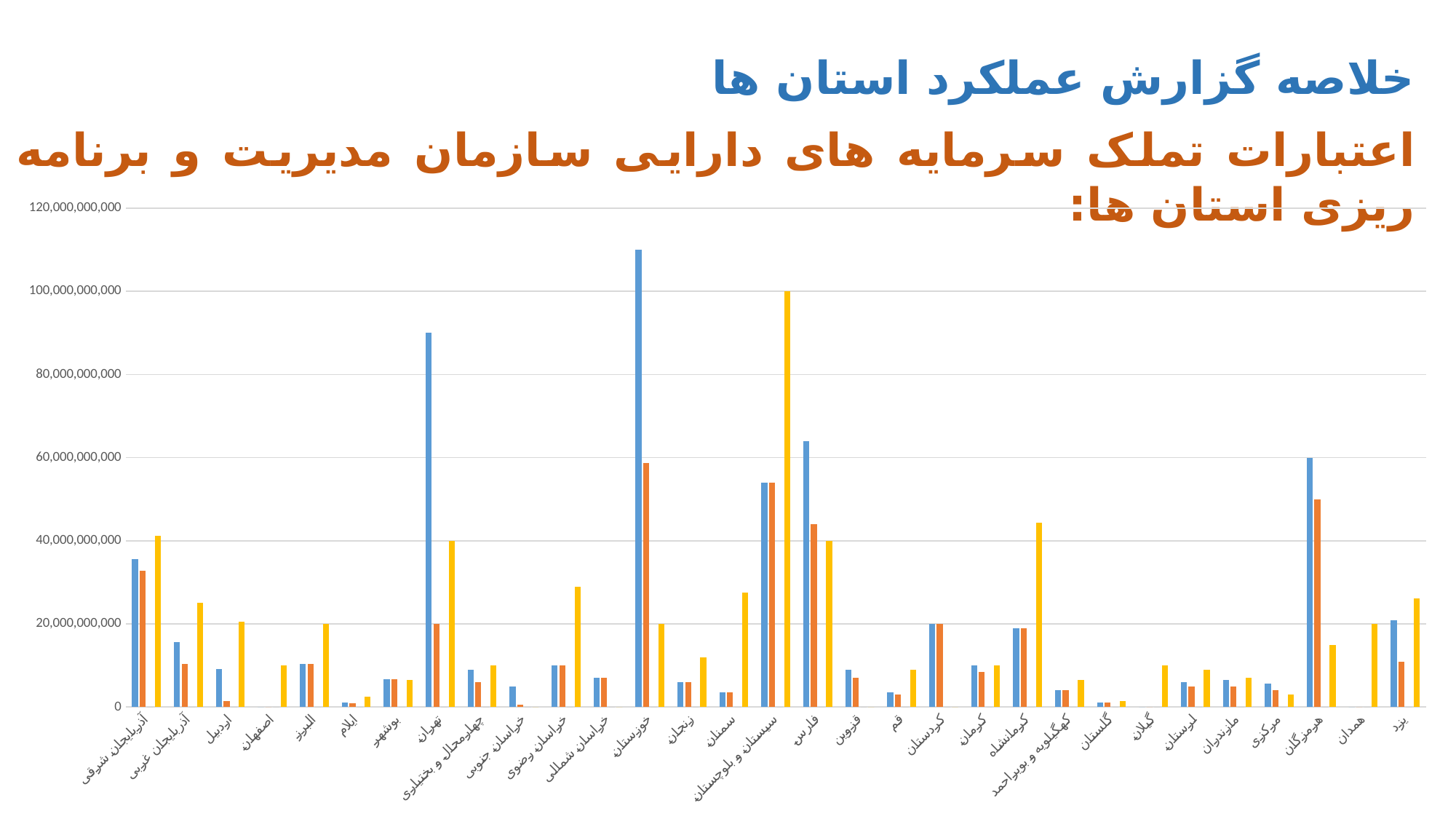
Is the blue bar for خوزستان greater or less than 100,000,000,000? greater How many differently coloured bar series does the chart plot for each province? 3 Is the blue bar for آذربایجان شرقی greater or less than 40,000,000,000? less Which is larger, the yellow bar for آذربایجان غربی or the yellow bar for اردبیل? آذربایجان غربی Is the orange bar for هرمزگان greater or less than 40,000,000,000? greater Which province has the tallest blue bar in the chart? خوزستان What kind of chart is shown on the slide? bar chart Which is larger, the blue bar for تهران or the blue bar for فارس? تهران How many provinces (categories) are shown along the x axis of the chart? 31 Which province has the tallest orange bar in the chart? خوزستان Which province has the tallest yellow bar in the chart? سیستان و بلوچستان